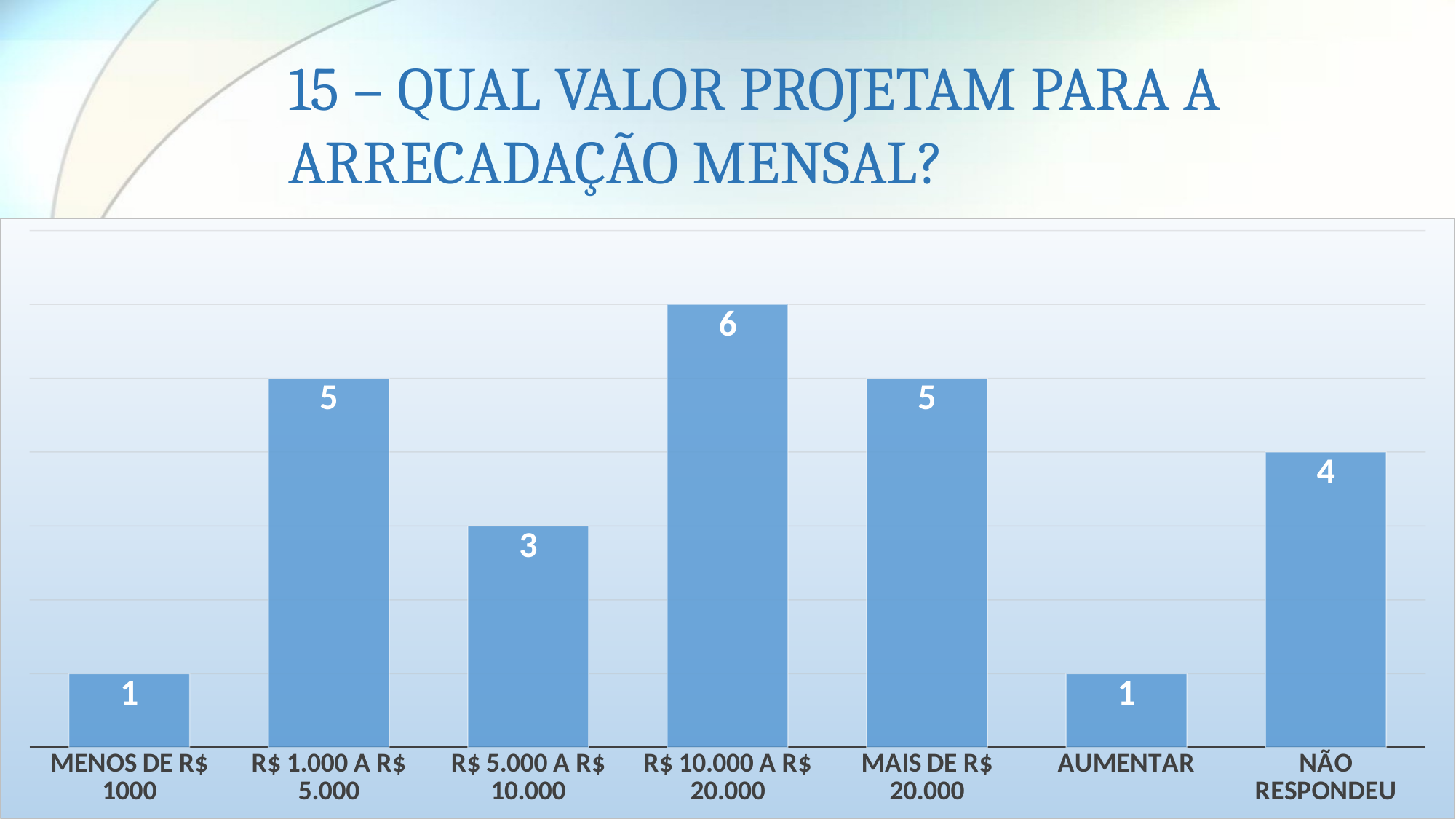
What is the value for R$ 10.000 A R$ 20.000? 6 What is the difference between the values for R$ 10.000 A R$ 20.000 and R$ 5.000 A R$ 10.000? 3 How many categories are shown on the x axis? 7 Which category has the highest value? R$ 10.000 A R$ 20.000 What is the title of the slide? 15 – QUAL VALOR PROJETAM PARA A ARRECADAÇÃO MENSAL? What is the value for AUMENTAR? 1 Which is larger, the value for R$ 1.000 A R$ 5.000 or the value for NÃO RESPONDEU? R$ 1.000 A R$ 5.000 What is the value for NÃO RESPONDEU? 4 What is the value for R$ 5.000 A R$ 10.000? 3 Which is larger, the value for R$ 5.000 A R$ 10.000 or the value for AUMENTAR? R$ 5.000 A R$ 10.000 What kind of chart is shown on the slide? Bar chart What is the difference between the values for NÃO RESPONDEU and MENOS DE R$ 1000? 3